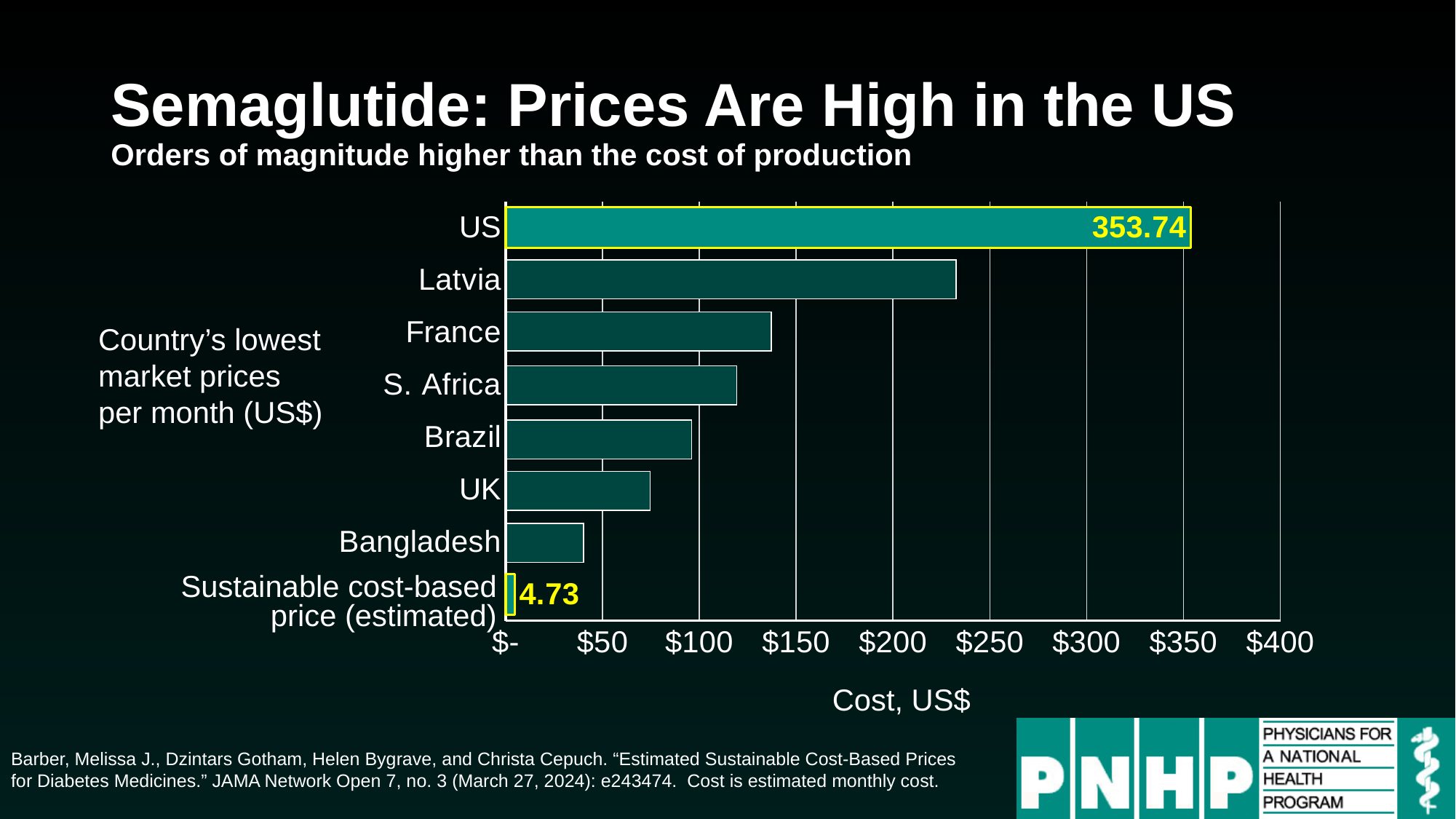
What is the value shown for the sustainable cost-based price (estimated)? 4.73 How many categories are shown in the chart? 8 Is the value for UK greater or less than $50? greater Is the value for Bangladesh greater or less than $50? less What kind of chart is shown on the slide? Bar chart What is the title of the horizontal axis? Cost, US$ Which category has the highest value? US Is the value for Latvia greater or less than $200? greater What is the value shown for the US? 353.74 Which category has the lowest value? Sustainable cost-based price (estimated) Which is larger, the value for Latvia or the value for France? Latvia What is the difference between the US value and the sustainable cost-based price (estimated)? 349.01